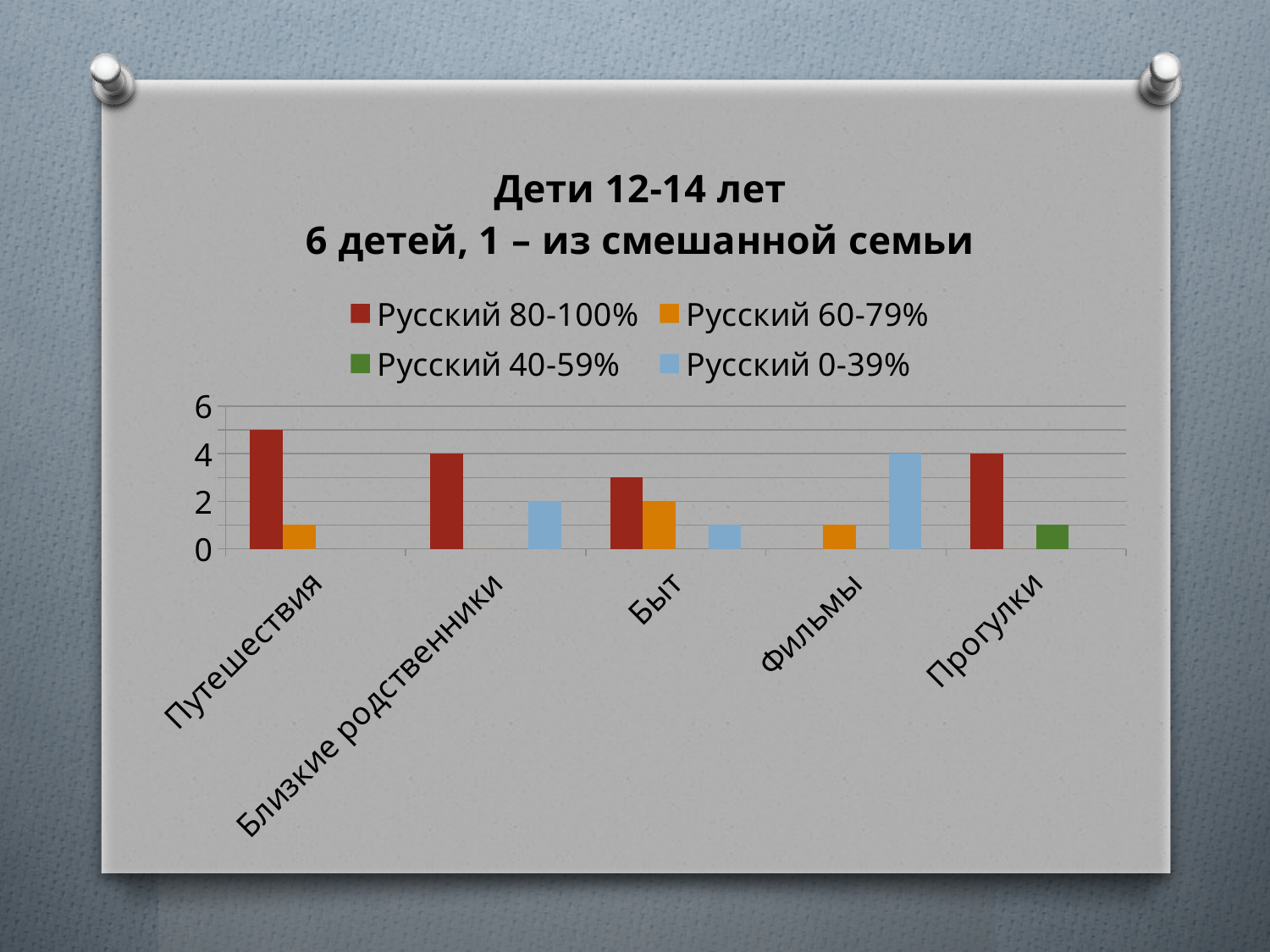
Is the value for Русский 80-100% in the Путешествия category greater or less than 4? greater Which category has the highest value for Русский 80-100%? Путешествия Which series is shown in green in the legend? Русский 40-59% How many series does the legend list? 4 What is the value for Русский 0-39% in the Фильмы category? 4 Is the value for Русский 80-100% in the Быт category greater or less than 4? less How many categories are shown on the x axis? 5 What is the value for Русский 0-39% in the Близкие родственники category? 2 What kind of chart is shown on the slide? bar chart Which is larger in the Фильмы category: Русский 60-79% or Русский 0-39%? Русский 0-39% What is the value for Русский 80-100% in the Близкие родственники category? 4 What is the value for Русский 60-79% in the Быт category? 2